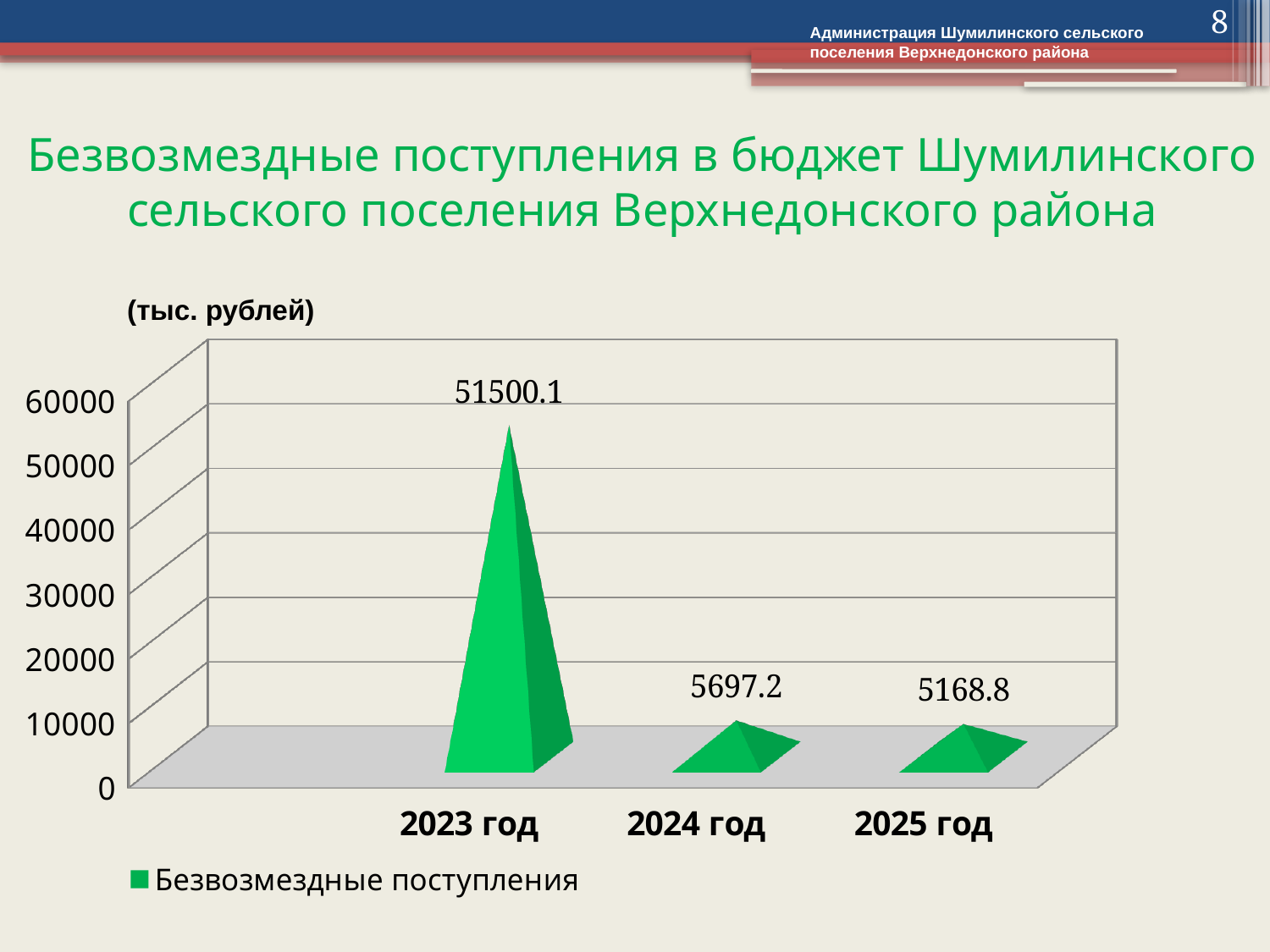
How many years are shown on the x axis? 3 What is the value for 2025 год? 5168.8 Is the value for 2023 год greater or less than 50000? greater Which year has the lowest value? 2025 год What is the value for 2024 год? 5697.2 Which is larger, the value for 2024 год or the value for 2025 год? 2024 год What is the difference between the values for 2023 год and 2024 год? 45802.9 What is the difference between the values for 2024 год and 2025 год? 528.4 What series name does the legend show? Безвозмездные поступления What is the value for 2023 год? 51500.1 Do the values rise or fall from 2023 год to 2025 год? fall Which year has the highest value? 2023 год